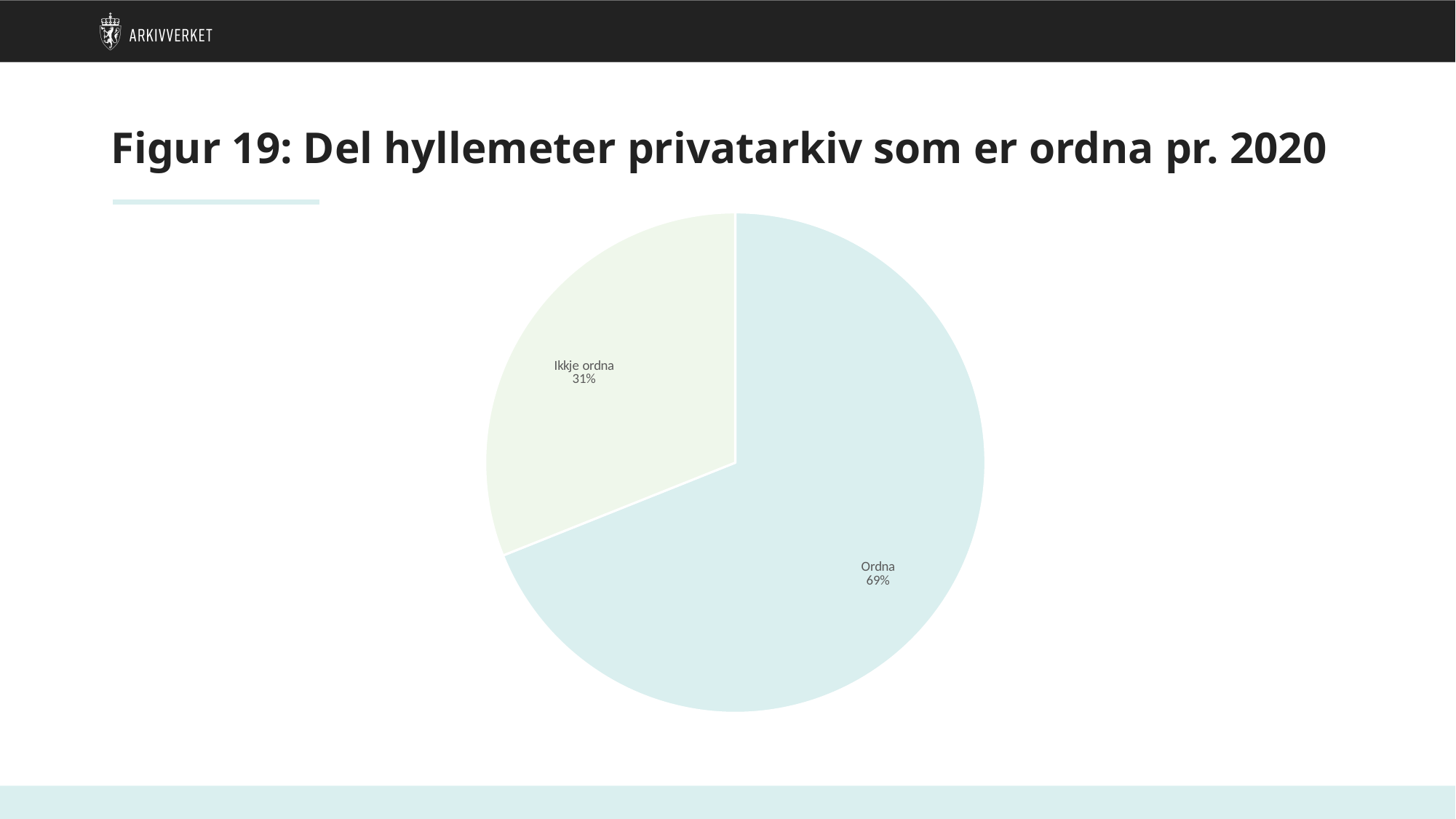
Which is larger, the "Ordna" slice or the "Ikkje ordna" slice? Ordna What share of the pie is labelled "Ordna"? 69% What share of the pie is labelled "Ikkje ordna"? 31% Is the share for "Ordna" greater or less than 50%? greater Which slice is the smallest? Ikkje ordna What is the title of the chart on the slide? Figur 19: Del hyllemeter privatarkiv som er ordna pr. 2020 What kind of chart is shown on the slide? pie chart How many slices does the pie chart have? 2 Which slice is the largest? Ordna What is the difference in percentage points between the "Ordna" and "Ikkje ordna" slices? 38